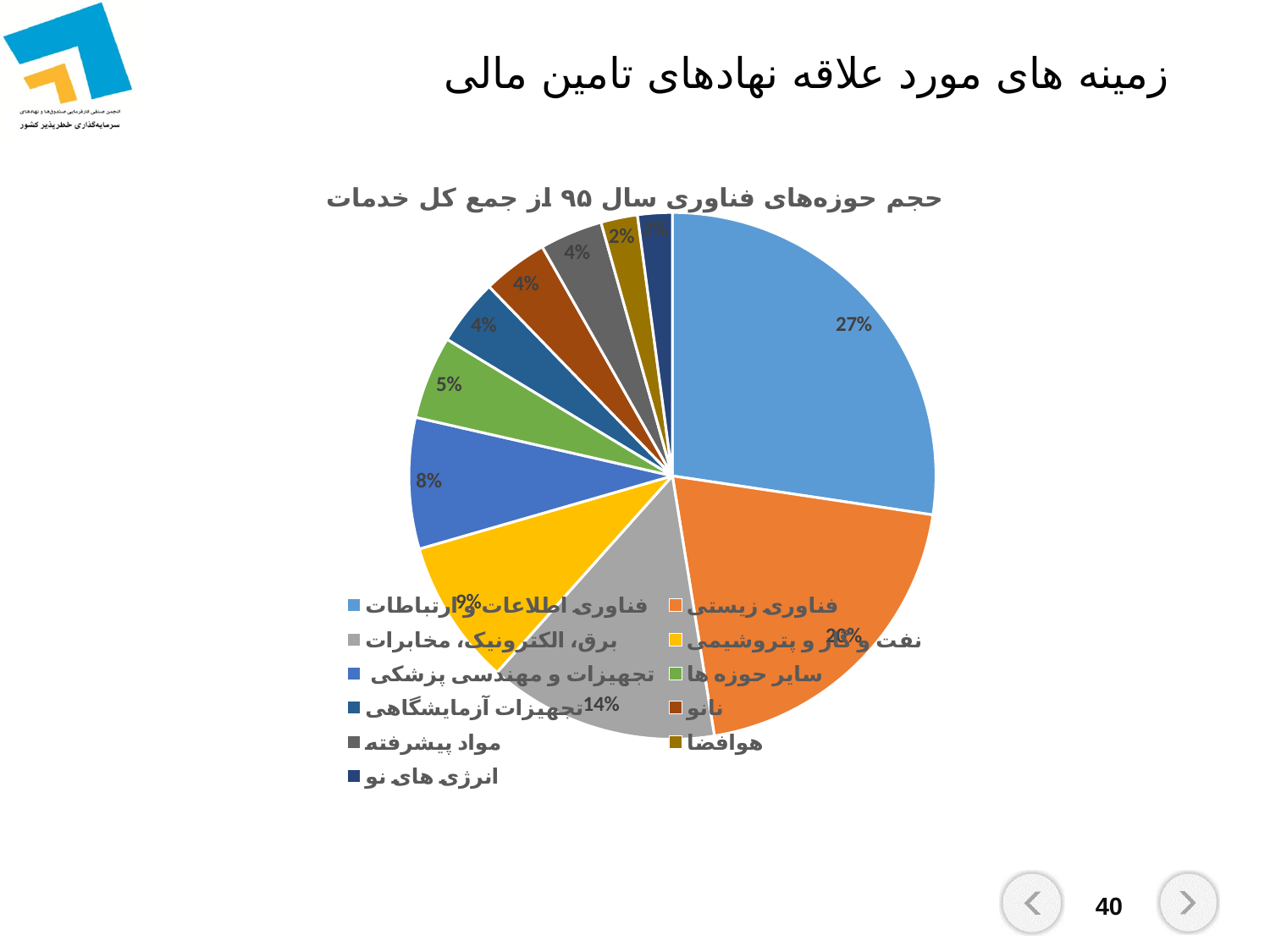
What share of the pie does برق، الکترونیک، مخابرات have? 14% What kind of chart is shown on the slide? pie chart How many categories does the legend list? 11 What is the title of the chart? حجم حوزه‌های فناوری سال ۹۵ از جمع کل خدمات What share of the pie does سایر حوزه ها have? 5% What share of the pie does فناوری اطلاعات و ارتباطات have? 27% What is the difference between the shares of فناوری اطلاعات و ارتباطات and فناوری زیستی? 7% Which is larger, the share of برق، الکترونیک، مخابرات or the share of تجهیزات و مهندسی پزشکی? برق، الکترونیک، مخابرات Which category has the largest slice of the pie? فناوری اطلاعات و ارتباطات